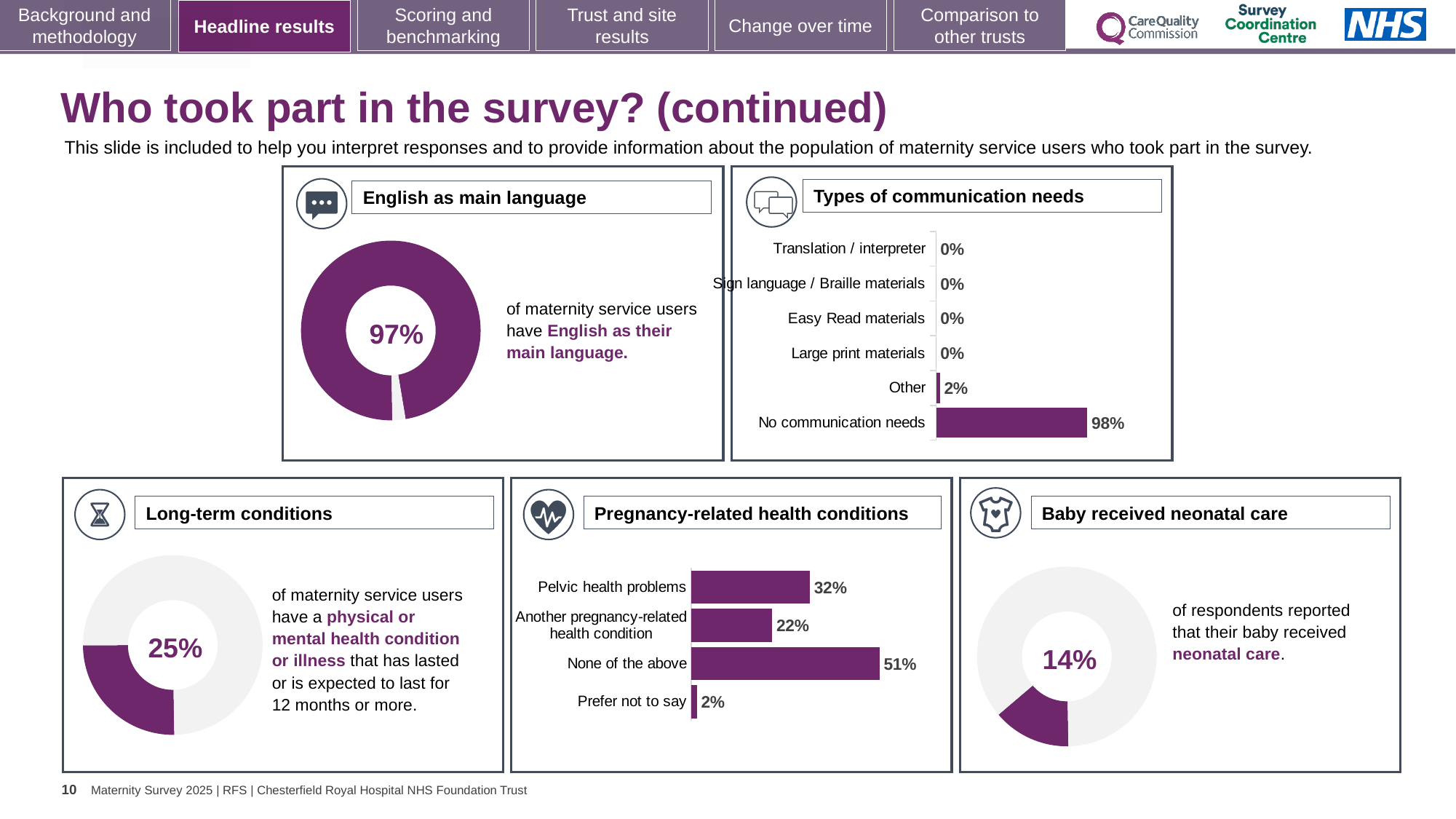
In the 'Types of communication needs' chart, what is the value for 'Other'? 2% In the 'English as main language' chart, what percentage of maternity service users have English as their main language? 97% In the 'Types of communication needs' chart, what is the difference between 'No communication needs' and 'Other'? 96% In the 'Types of communication needs' chart, which category has the highest value? No communication needs In the 'Pregnancy-related health conditions' chart, which category has the highest value? None of the above In the 'Pregnancy-related health conditions' chart, what is the value for 'Pelvic health problems'? 32% In the 'Types of communication needs' chart, what is the value for 'No communication needs'? 98% In the 'Baby received neonatal care' chart, what percentage of respondents reported that their baby received neonatal care? 14% In the 'Pregnancy-related health conditions' chart, what is the difference between 'Pelvic health problems' and 'Another pregnancy-related health condition'? 10% In the 'Types of communication needs' chart, how many categories are shown? 6 In the 'Long-term conditions' chart, what percentage of maternity service users have a physical or mental health condition or illness? 25% What kind of chart is the 'Pregnancy-related health conditions' chart? Bar chart